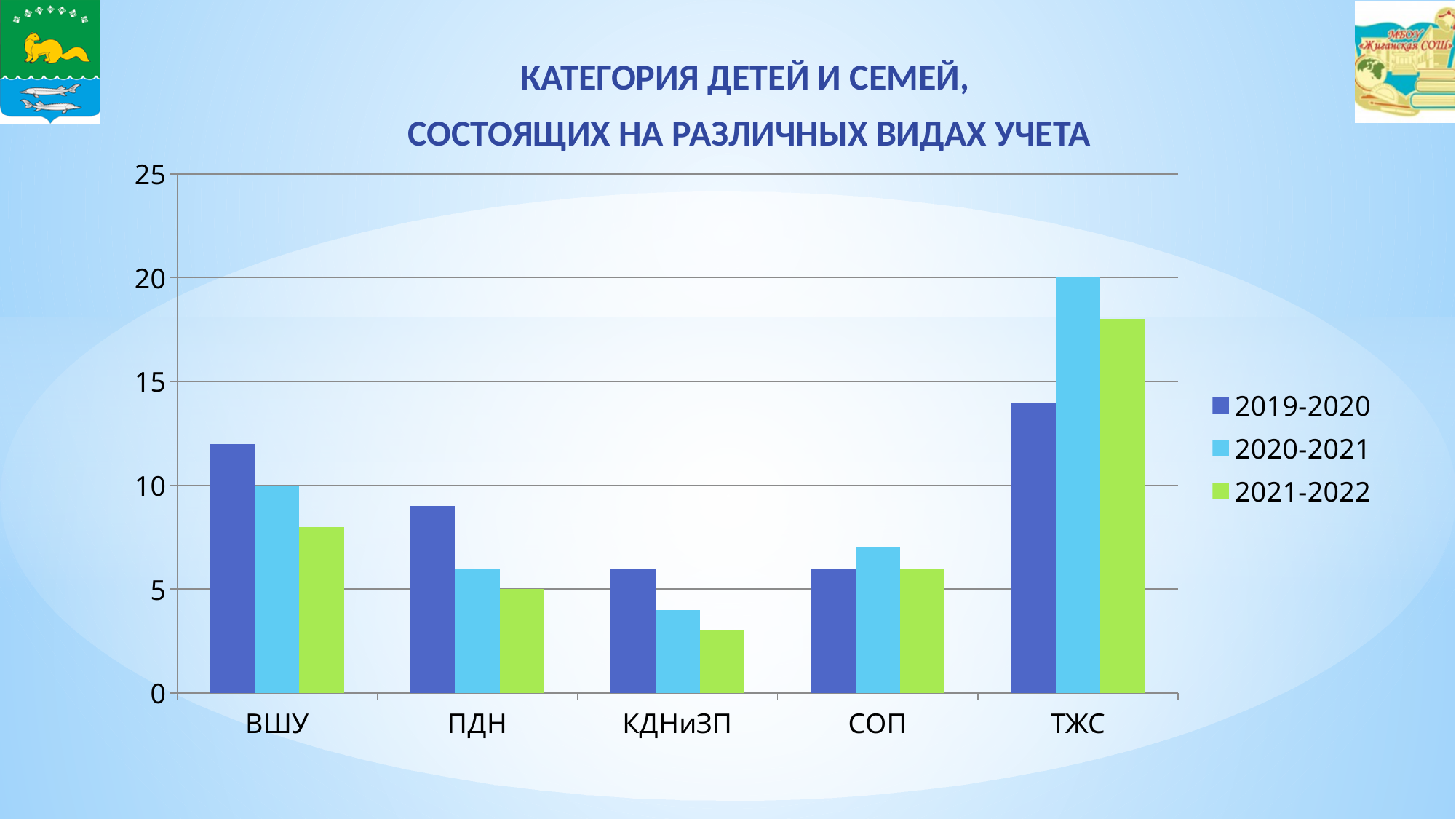
Which category has the lowest value in the 2021-2022 series? КДНиЗП What is the value for ТЖС in the 2020-2021 series? 20 How many series does the legend list? 3 What kind of chart is shown on the slide? bar chart What is the value for ВШУ in the 2020-2021 series? 10 Is the value for ТЖС in the 2021-2022 series greater or less than 15? greater Is the value for ВШУ in the 2019-2020 series greater or less than 10? greater How many categories are shown on the x axis? 5 Do the values for КДНиЗП rise or fall from 2019-2020 to 2021-2022? fall Which is larger for СОП: the 2020-2021 value or the 2019-2020 value? 2020-2021 Which category has the highest value in the 2019-2020 series? ТЖС What is the value for ПДН in the 2021-2022 series? 5